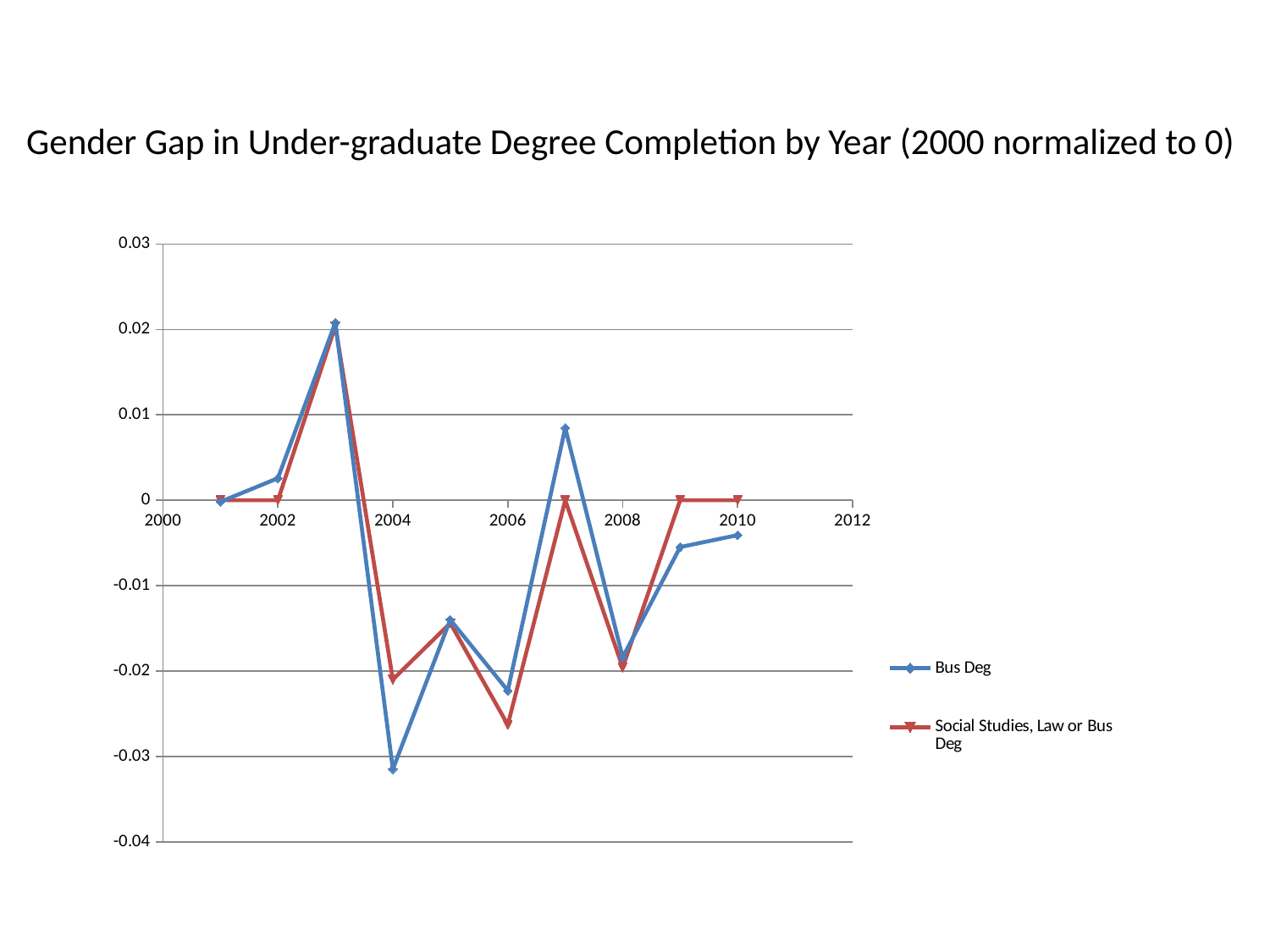
What is the value of the Social Studies, Law or Bus Deg series in 2010? 0 In which year does the Bus Deg series reach its highest value? 2003 In which year does the Bus Deg series reach its lowest value? 2004 How many data points are plotted for the Bus Deg series? 10 Between 2008 and 2010, does the Bus Deg series rise or fall? rise In 2004, which series has the larger value, Bus Deg or Social Studies, Law or Bus Deg? Social Studies, Law or Bus Deg Is the Bus Deg value for 2003 greater or less than 0.01? greater How many series does the legend list? 2 Is the Social Studies, Law or Bus Deg value for 2006 greater or less than -0.02? less Is the Bus Deg value for 2004 greater or less than -0.02? less What kind of chart is shown on the slide? line chart What is the title of the chart? Gender Gap in Under-graduate Degree Completion by Year (2000 normalized to 0)